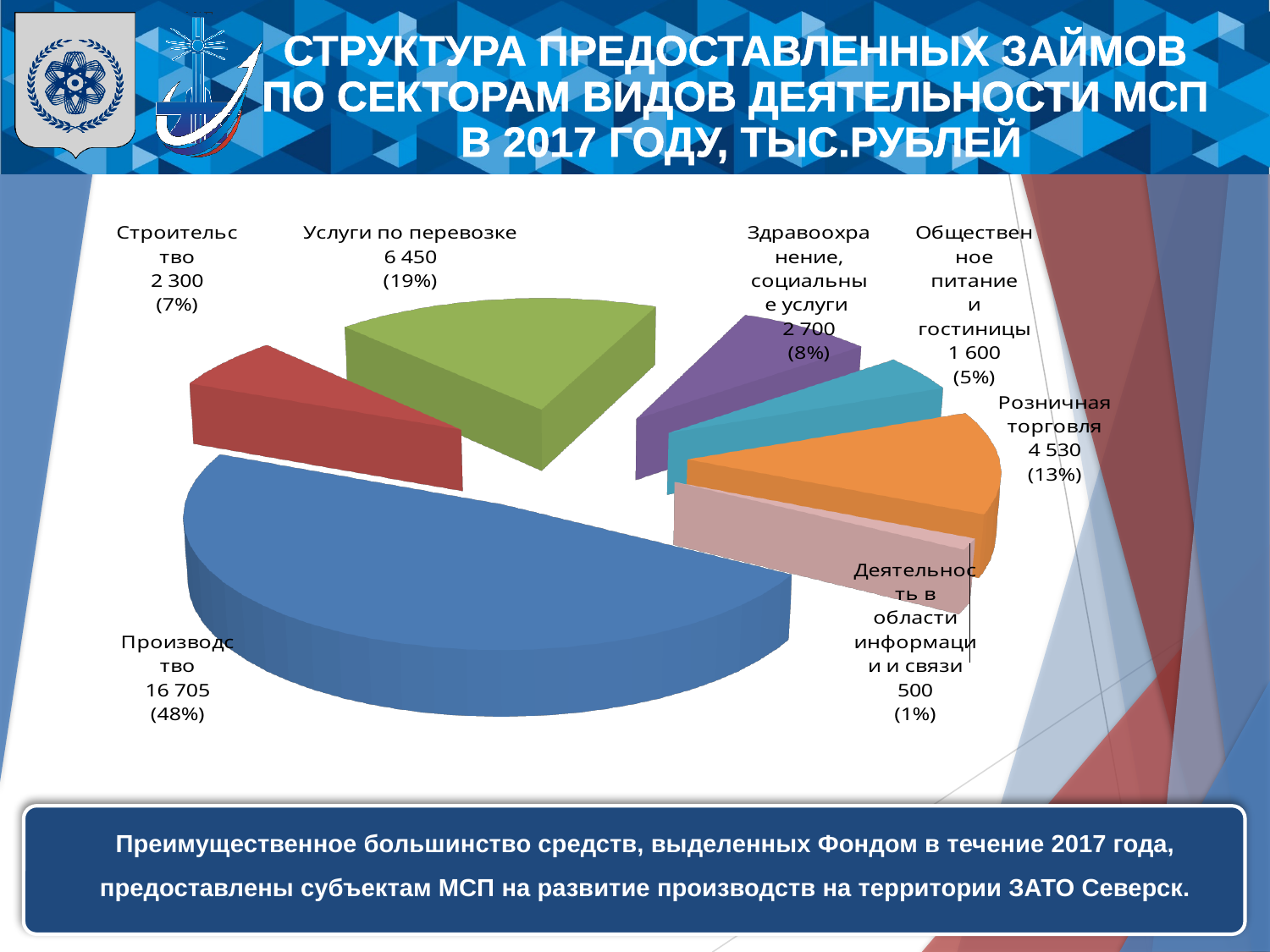
How many sectors (slices) does the pie chart show? 7 What kind of chart is shown on the slide? pie chart What is the value for Розничная торговля? 4 530 What is the value for Производство? 16 705 Which is larger, the value for Розничная торговля or the value for Здравоохранение, социальные услуги? Розничная торговля What is the value for Деятельность в области информации и связи? 500 Which sector has the largest share of the pie? Производство Which sector has the smallest share of the pie? Деятельность в области информации и связи What is the value for Услуги по перевозке? 6 450 What share of the pie does Общественное питание и гостиницы represent? 5% What is the difference between the values for Услуги по перевозке and Строительство? 4 150 What share of the pie does Здравоохранение, социальные услуги represent? 8%